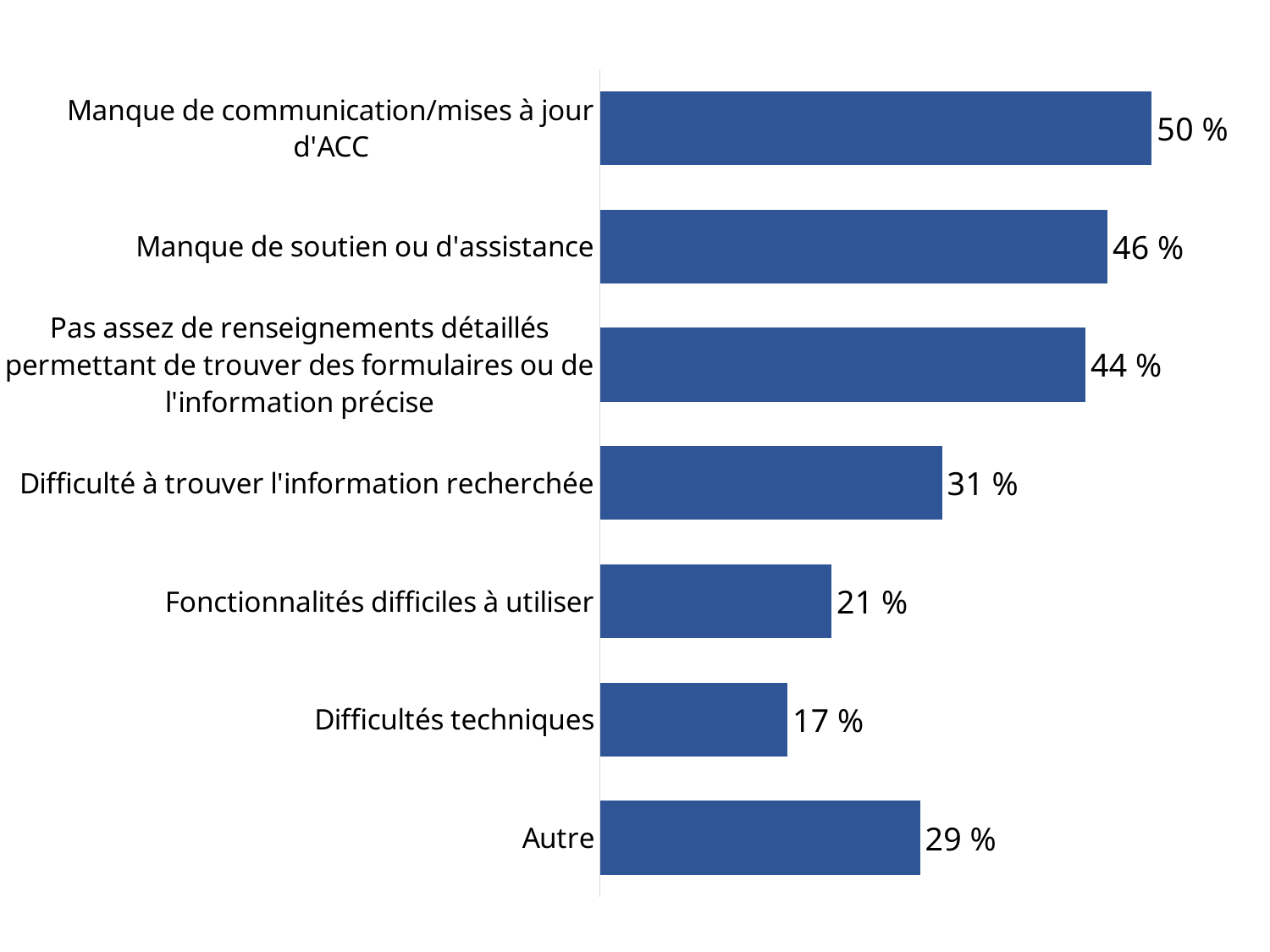
What is the difference between the values for "Manque de communication/mises à jour d'ACC" and "Manque de soutien ou d'assistance"? 4 % What is the value for "Difficultés techniques"? 17 % Which category has the highest value? Manque de communication/mises à jour d'ACC What is the value for "Autre"? 29 % Which is larger: the value for "Autre" or the value for "Fonctionnalités difficiles à utiliser"? Autre What colour are the bars in the chart? Blue What is the value for "Fonctionnalités difficiles à utiliser"? 21 % What kind of chart is shown on the slide? Bar chart What is the difference between the values for "Difficulté à trouver l'information recherchée" and "Autre"? 2 % What is the value for "Manque de soutien ou d'assistance"? 46 % How many categories are shown in the chart? 7 Which category has the lowest value? Difficultés techniques